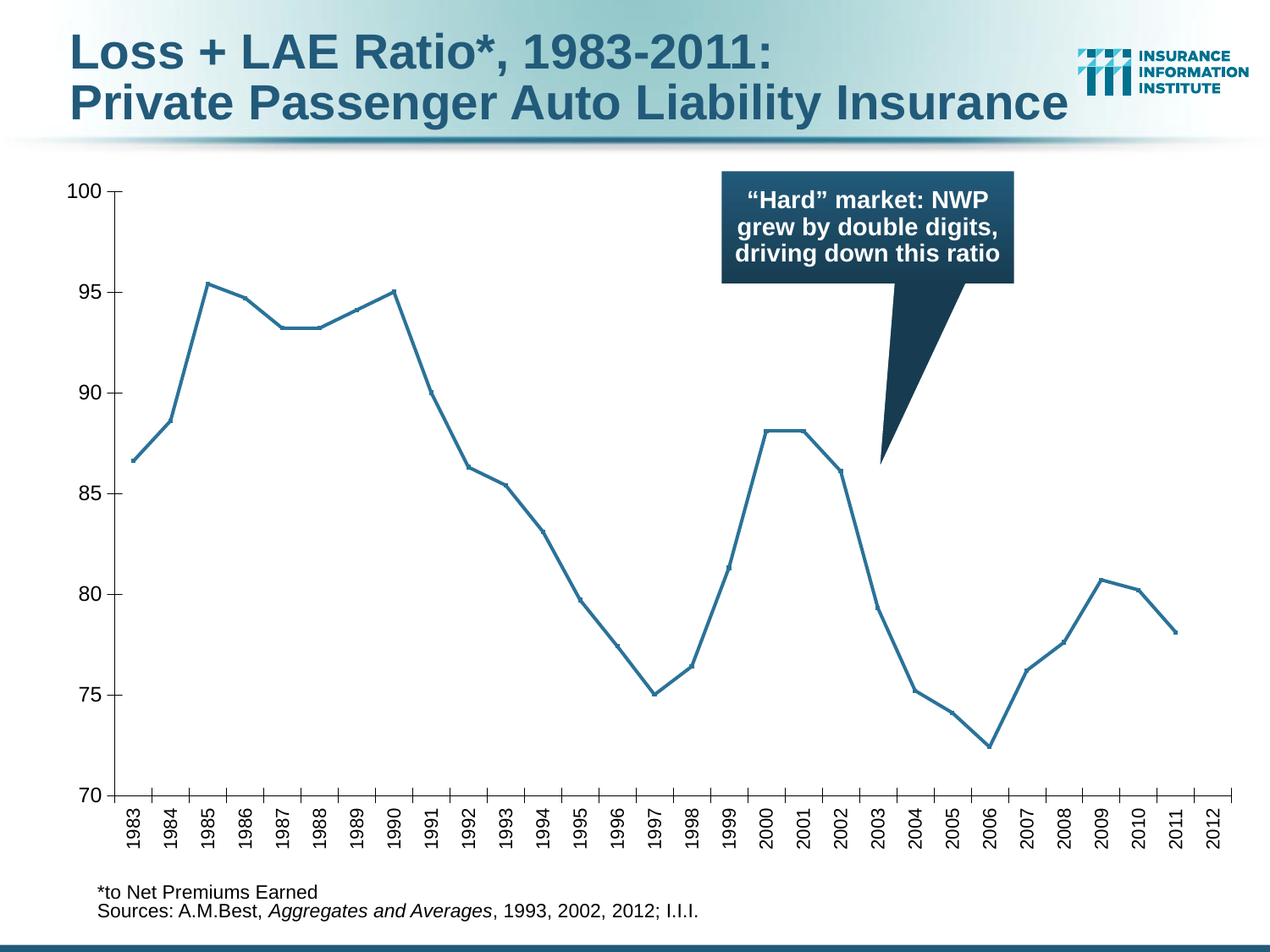
Which year has the lowest Loss + LAE ratio on the chart? 2006 Is the value for 1996 greater or less than 80? less Does the ratio rise or fall from 2006 to 2009? rise Is the value for 2006 greater or less than 75? less According to the callout on the chart, what drove down the ratio during the "hard" market? NWP grew by double digits Which year has the higher ratio, 1999 or 2002? 2002 How many years of data are plotted on the chart? 29 Which year has the higher ratio, 2000 or 2011? 2000 Is the value for 1983 greater or less than 85? greater Does the ratio rise or fall from 1990 to 1997? fall What kind of chart is shown on the slide? line chart